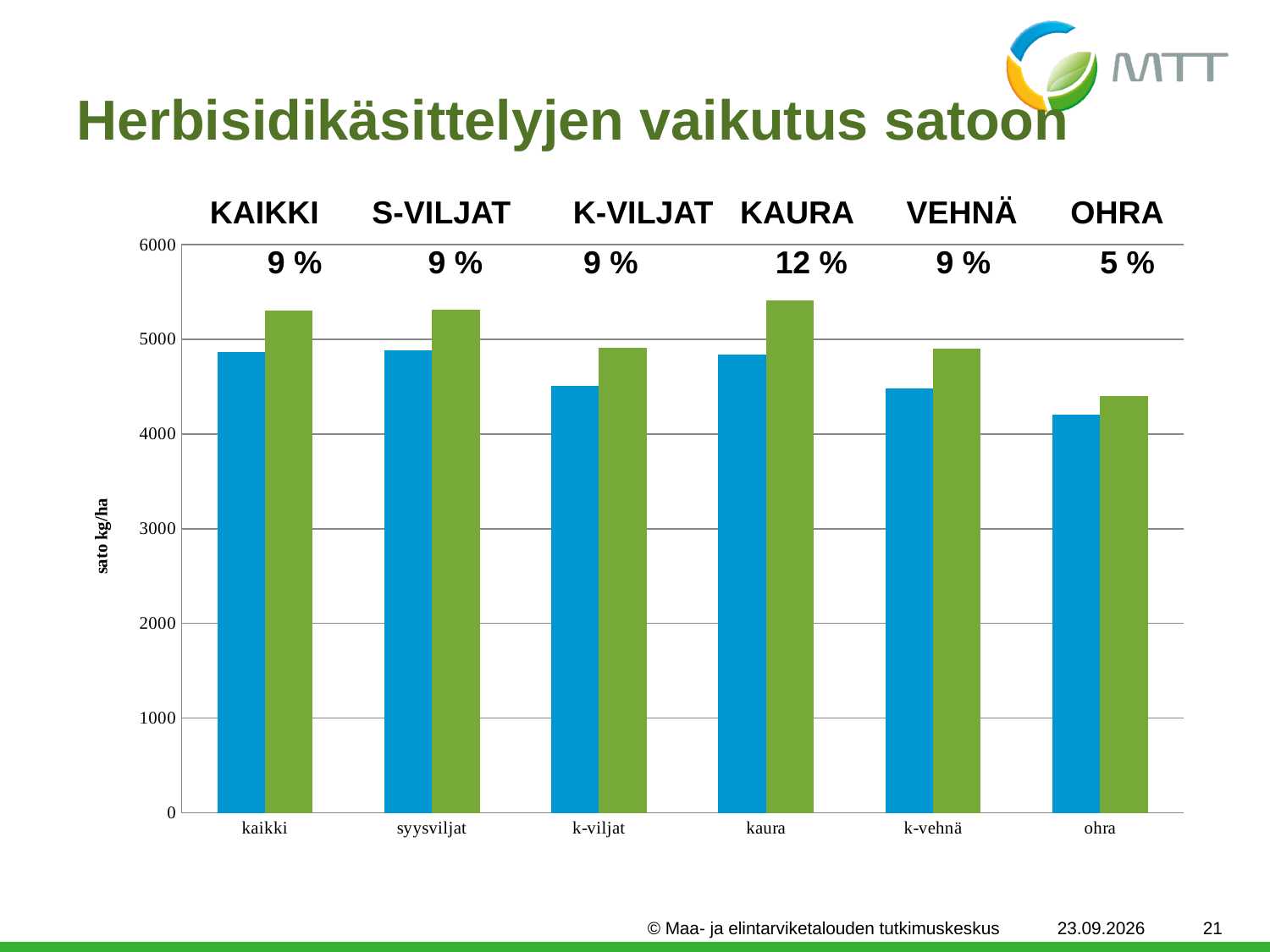
What percentage is printed above the OHRA category? 5 % What percentage is printed above the VEHNÄ category? 9 % Is the green bar for kaura greater or less than 5000? greater Is the green bar for ohra greater or less than 5000? less Which category has the highest percentage printed above it? KAURA How many bars are plotted for each category in the chart? 2 What kind of chart is shown on the slide? bar chart How many categories are shown on the x axis of the chart? 6 What percentage is printed above the KAURA category? 12 % Is the blue bar for ohra greater or less than 4500? less Which category has the lowest percentage printed above it? OHRA For the kaura category, which bar is taller, the blue one or the green one? green